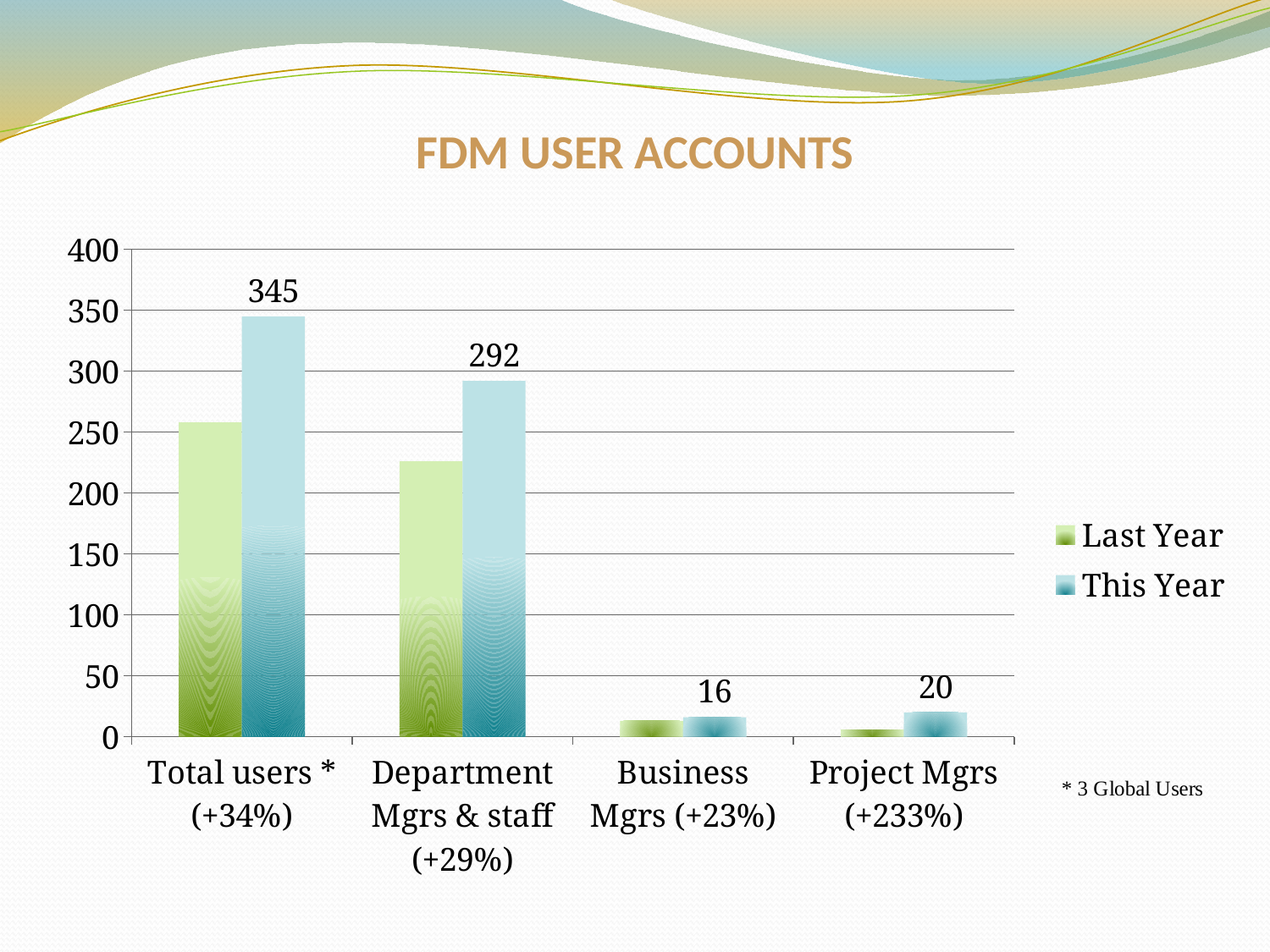
What is the difference between the This Year values for Total users and Department Mgrs & staff? 53 Which category has the lowest This Year value? Business Mgrs What is the This Year value for Business Mgrs? 16 Is the Last Year value for Department Mgrs & staff greater or less than 250? less Which is larger for Last Year: Business Mgrs or Project Mgrs? Business Mgrs How many categories are shown on the x axis? 4 What is the This Year value for Total users? 345 What is the This Year value for Project Mgrs? 20 Which category has the highest This Year value? Total users What type of chart is shown on the slide? Bar chart What is the This Year value for Department Mgrs & staff? 292 How many series does the legend list? 2